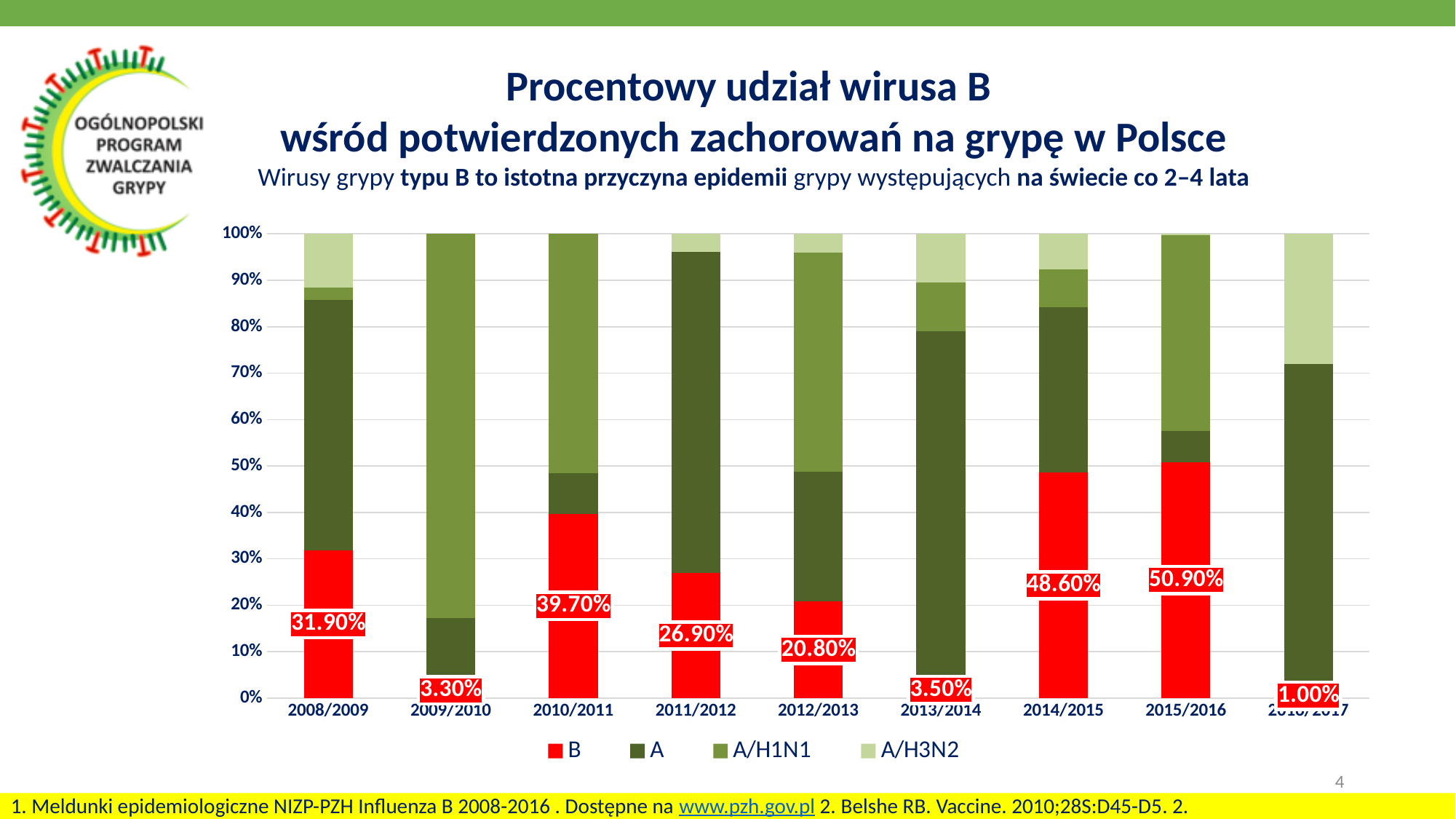
What kind of chart is shown on the slide? stacked bar chart What is the value for B in the 2016/2017 season? 1.00% What is the value for B in the 2015/2016 season? 50.90% What is the value for B in the 2012/2013 season? 20.80% Which season has the highest value for B? 2015/2016 What is the value for B in the 2008/2009 season? 31.90% Which is larger, the B value for 2010/2011 or for 2011/2012? 2010/2011 How many seasons are shown on the x axis? 9 How many series does the legend list? 4 Is the A/H1N1 share in 2009/2010 greater or less than 80%? greater Which season has the lowest value for B? 2016/2017 What is the difference between the B values for 2015/2016 and 2014/2015? 2.30%